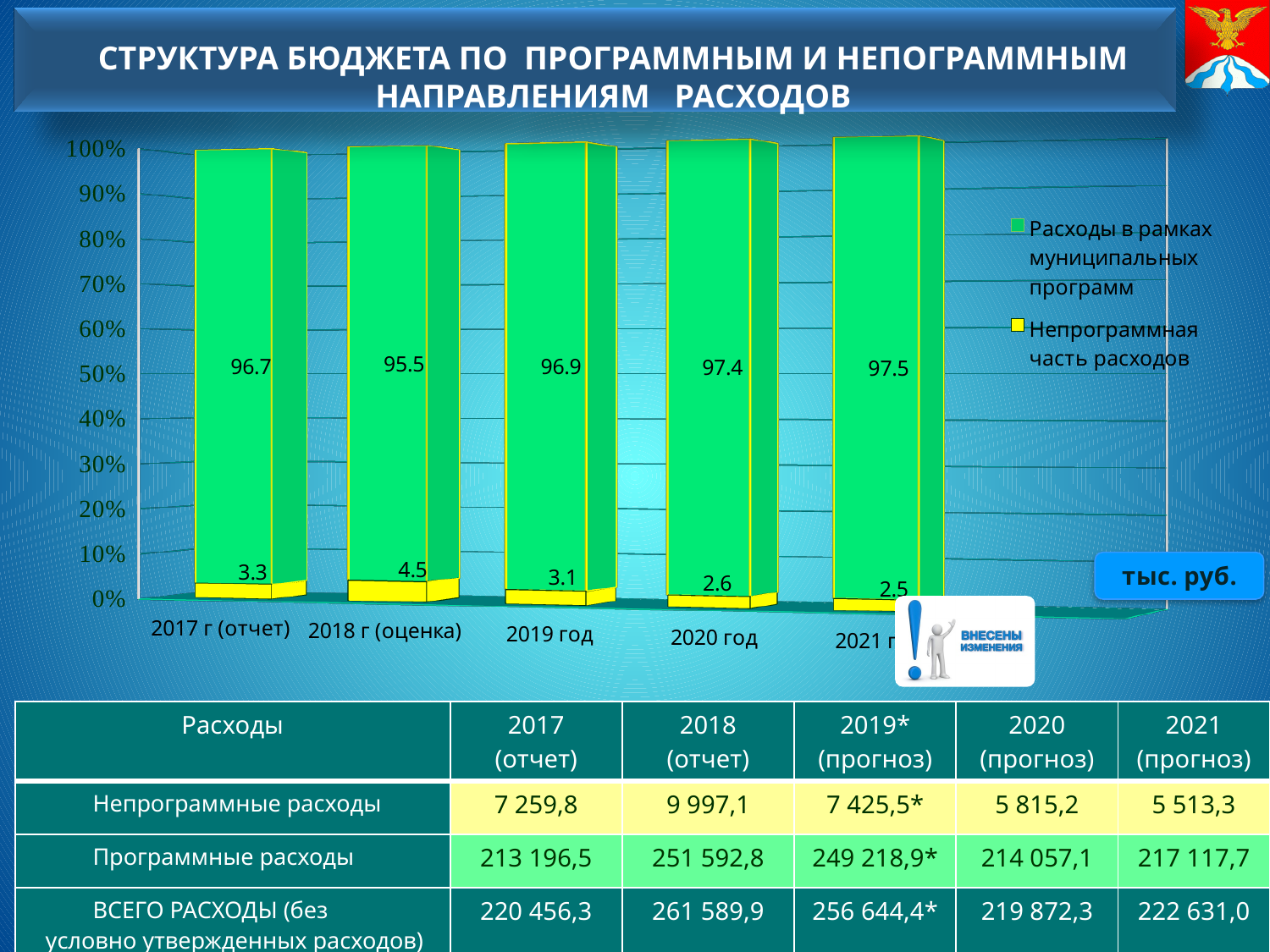
What is the difference between the green series values for 2021 г and 2017 г (отчет)? 0.8 Does the value of Непрограммная часть расходов rise or fall from 2018 г (оценка) to 2021 г? Fall What is the value of the yellow series (Непрограммная часть расходов) for 2019 год? 3.1 How many series does the chart legend list? 2 Which year has the lowest value for Расходы в рамках муниципальных программ? 2018 г (оценка) What is the value of the green series for 2021 г? 97.5 How many years (categories) are shown on the x axis of the chart? 5 Which year has the highest value for Непрограммная часть расходов? 2018 г (оценка) What kind of chart is shown on the slide? Stacked bar chart What is the value of the green series (Расходы в рамках муниципальных программ) for 2018 г (оценка)? 95.5 Which is larger: the yellow series value for 2017 г (отчет) or for 2020 год? 2017 г (отчет) Which colour represents Непрограммная часть расходов in the chart? Yellow